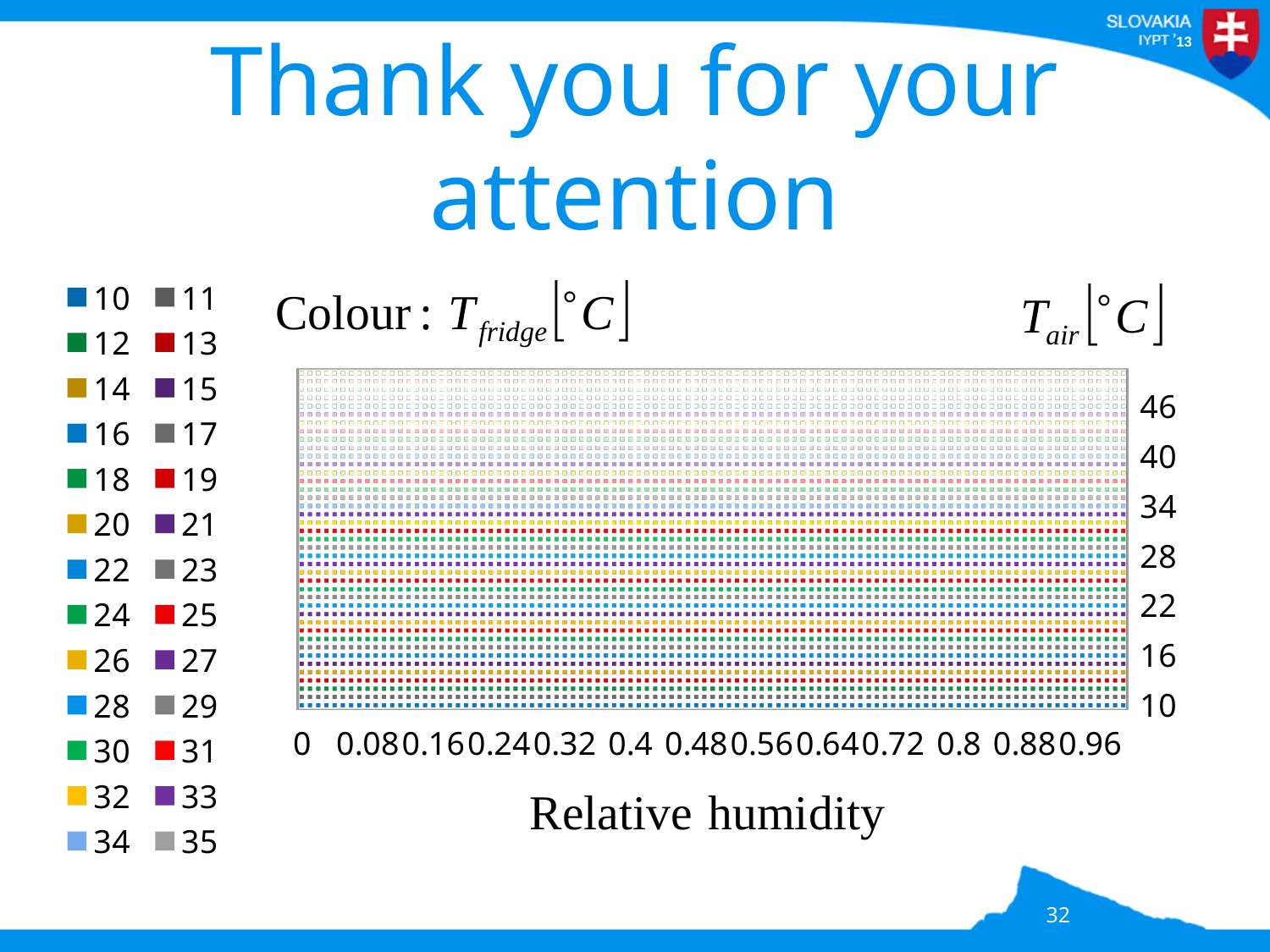
How many series does the legend list? 26 What is the highest tick value shown on the x axis? 0.96 What quantity does the colour of the points represent? T_fridge [°C] What is the largest value listed in the legend? 35 What is the spacing between consecutive ticks on the y axis? 6 What is the highest tick value shown on the y axis? 46 What is the spacing between consecutive ticks on the x axis? 0.08 What is the lowest tick value shown on the y axis? 10 What is the smallest value listed in the legend? 10 What kind of chart is shown on the slide? scatter chart What is the label of the x axis? Relative humidity